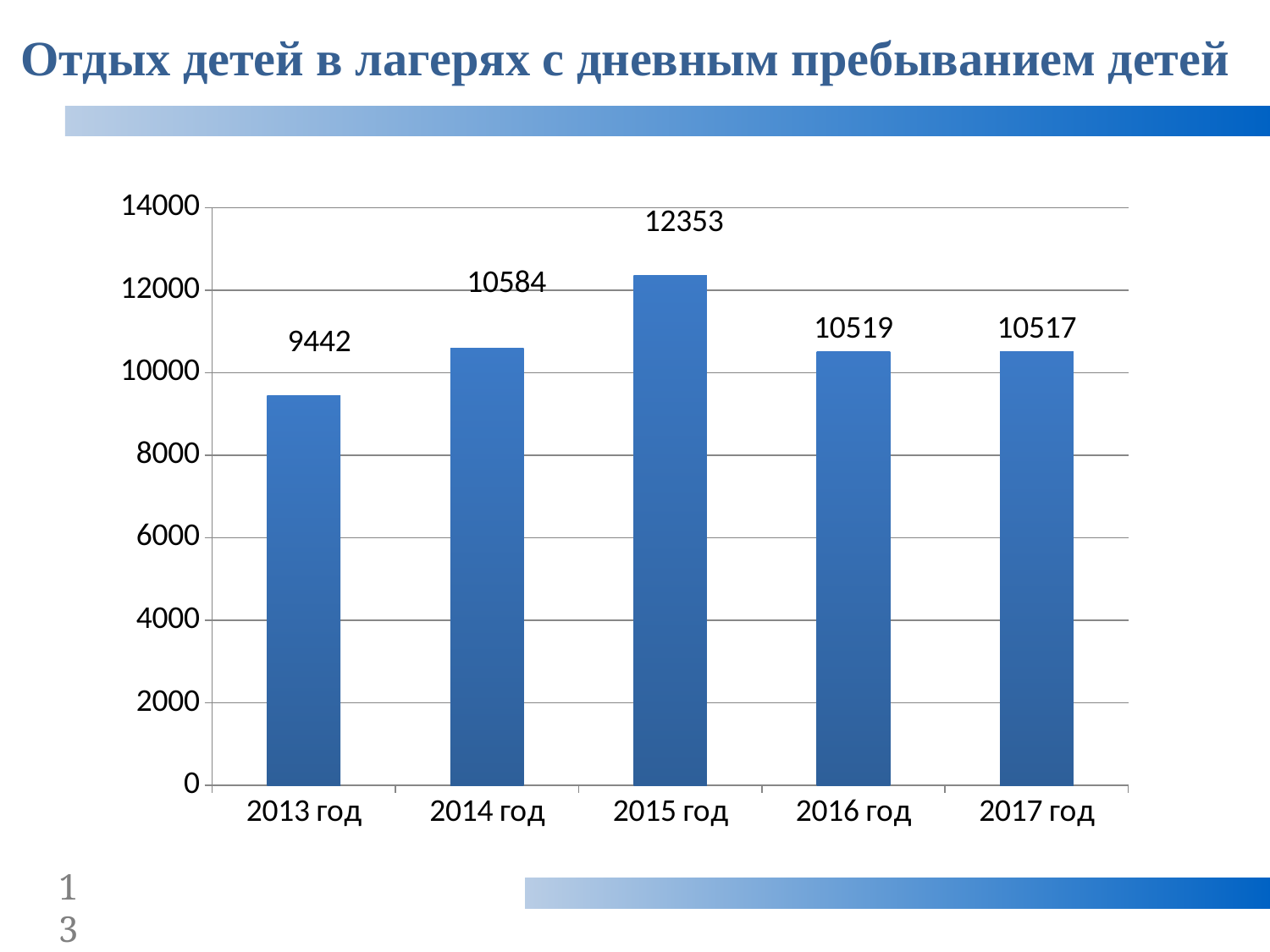
Which year has the highest value? 2015 год What is the value for 2013 год? 9442 How many years are shown on the x axis? 5 What is the difference between the values for 2014 год and 2013 год? 1142 What is the difference between the values for 2015 год and 2014 год? 1769 Which year has the lowest value? 2013 год Which is larger, the value for 2014 год or the value for 2013 год? 2014 год Is the value for 2013 год greater or less than 10000? less What kind of chart is shown on the slide? bar chart What is the value for 2017 год? 10517 What is the title of the slide? Отдых детей в лагерях с дневным пребыванием детей What is the value for 2015 год? 12353